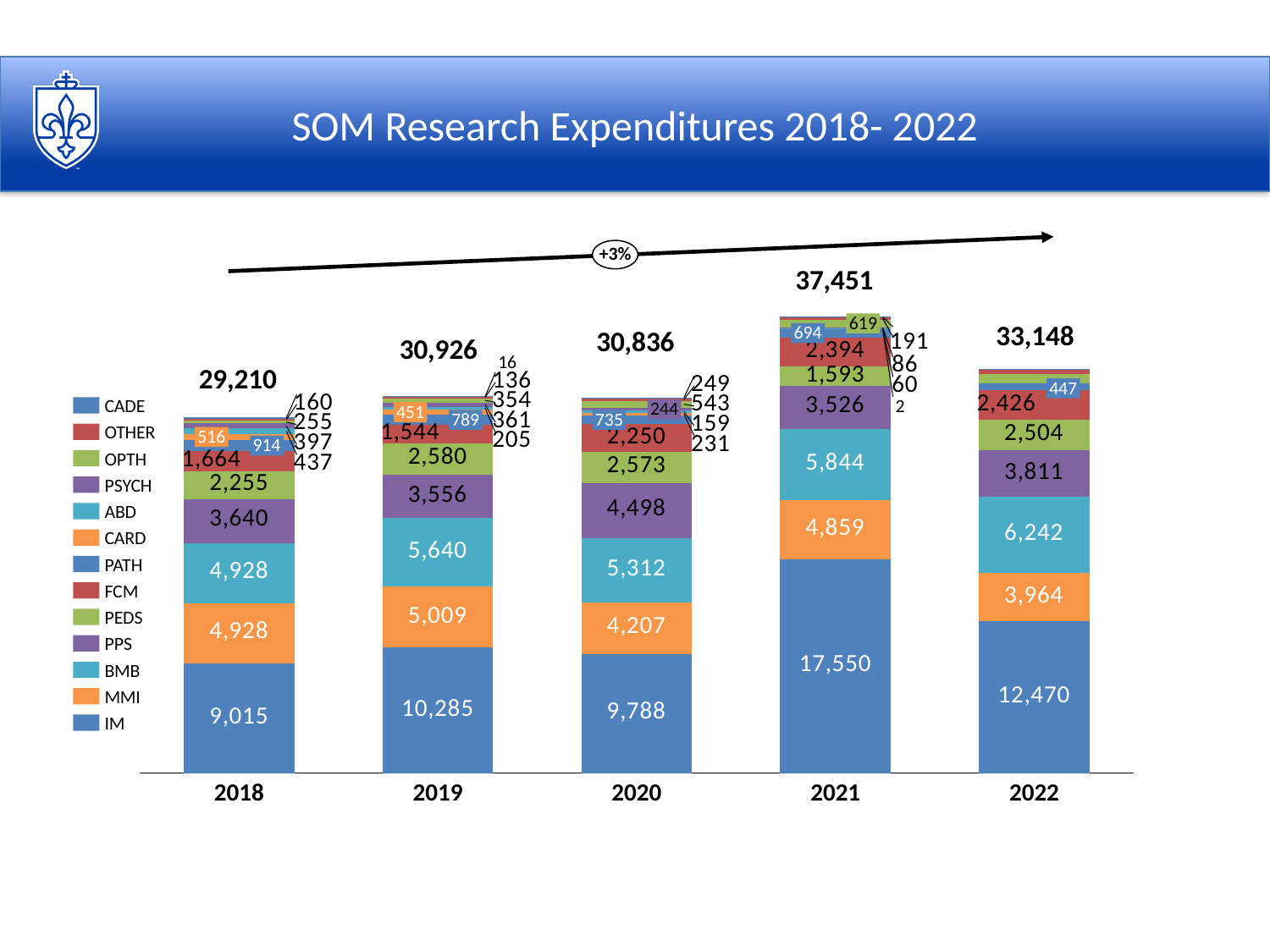
What percentage growth is annotated on the arrow above the bars? +3% How many series does the legend list? 13 What is the total shown above the 2018 bar? 29,210 What is the value of the bottom (IM) segment in the 2022 bar? 12,470 Which year has the lowest total research expenditure? 2018 In which year is the bottom (IM) segment the largest? 2021 How many years are shown on the x axis? 5 Which year has the highest total research expenditure? 2021 Which is larger, the 2019 total or the 2020 total? 2019 total (30,926) What is the difference between the 2021 total (37,451) and the 2018 total (29,210)? 8,241 What is the total research expenditure shown above the 2021 bar? 37,451 What kind of chart is shown on the slide? Stacked bar chart